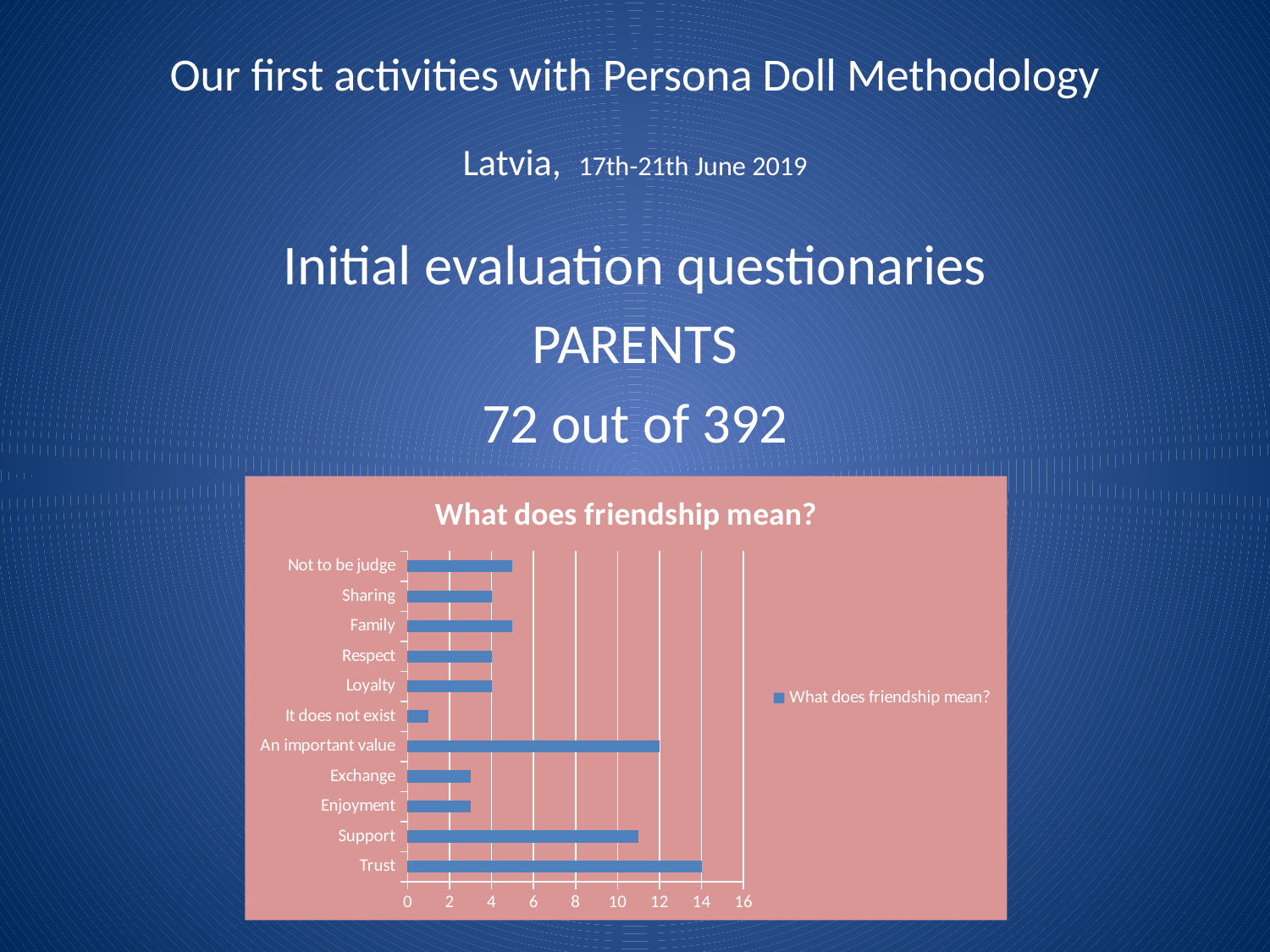
Is the value for Exchange greater or less than 4? less Which category has the highest value in the chart? Trust What is the value for An important value? 12 What is the title of the chart? What does friendship mean? Is the value for Support greater or less than 10? greater Which is larger, the value for Support or the value for Enjoyment? Support How many categories are plotted in the chart? 11 What kind of chart is shown on the slide? bar chart How many series does the legend list? 1 Is the value for It does not exist greater or less than 2? less Which category has the lowest value in the chart? It does not exist What is the value for Trust? 14